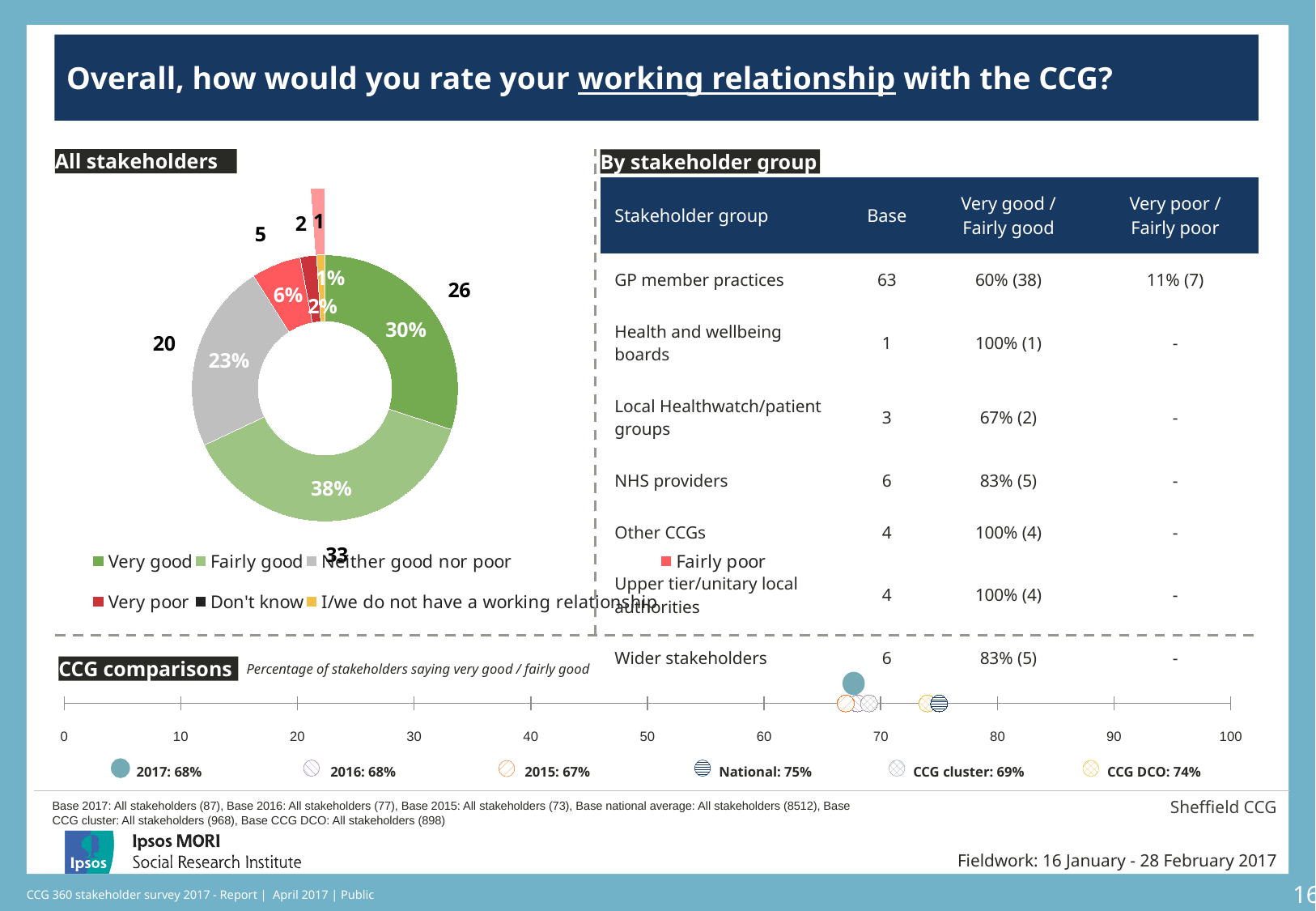
In the All stakeholders donut chart, what percentage of stakeholders rated the working relationship as Fairly good? 38% In the All stakeholders donut chart, which response category has the largest share? Fairly good In the All stakeholders donut chart, which is larger: the share for Neither good nor poor or the share for Fairly poor? Neither good nor poor How many entries does the legend of the All stakeholders donut chart list? 7 In the CCG comparisons chart, what is the percentage of stakeholders saying very good / fairly good for 2017? 68% In the All stakeholders donut chart, what is the difference in percentage points between Fairly good and Very good? 8 In the All stakeholders donut chart, what percentage of stakeholders rated the working relationship as Fairly poor? 6% In the All stakeholders donut chart, what percentage of stakeholders said Neither good nor poor? 23% What type of chart is used in the All stakeholders section? Donut (pie) chart In the CCG comparisons chart, what is the difference in percentage points between the National figure and the 2017 figure? 7 In the CCG comparisons chart, what is the National percentage of stakeholders saying very good / fairly good? 75% In the All stakeholders donut chart, what percentage of stakeholders rated the working relationship as Very good? 30%